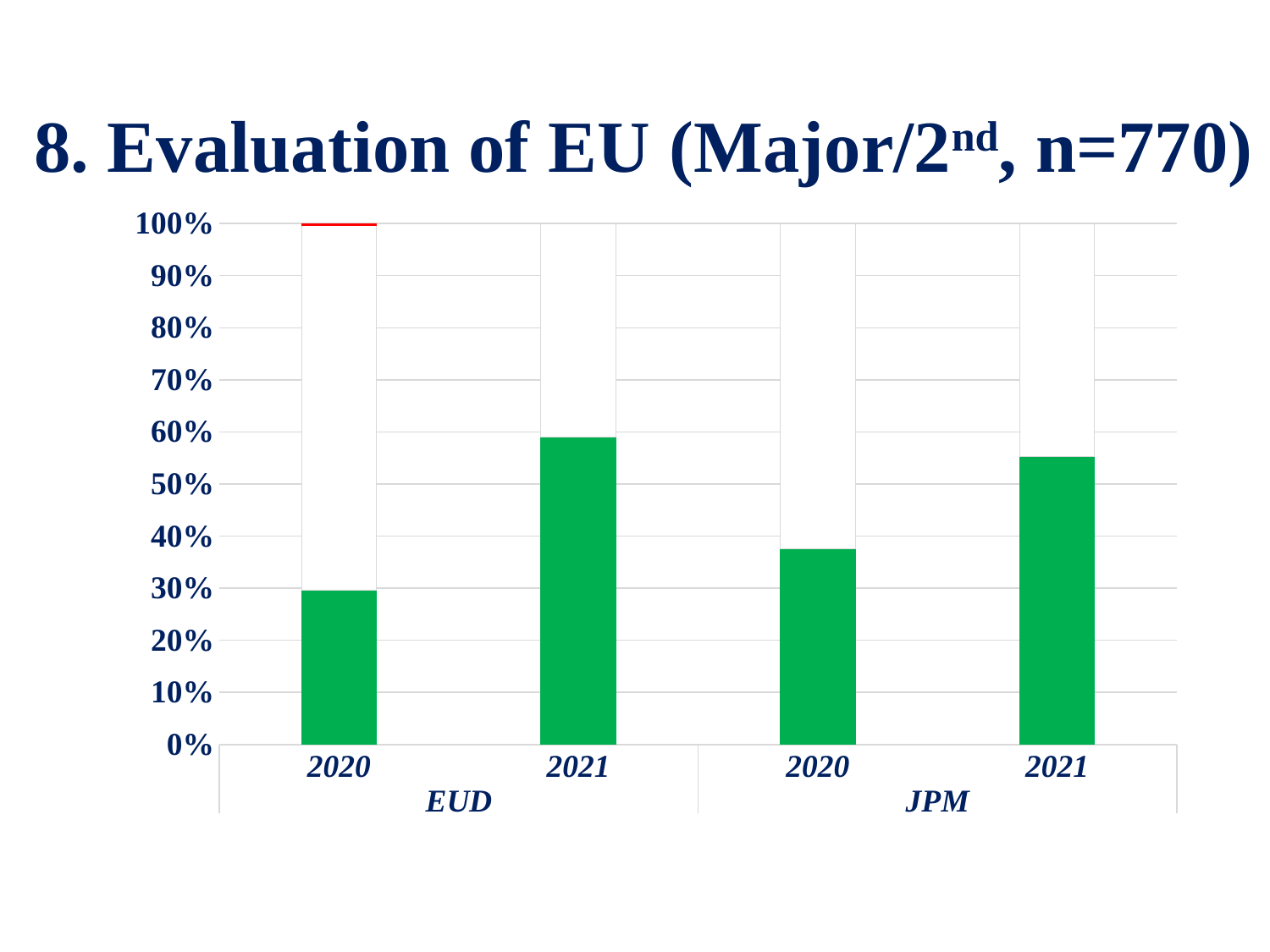
Which bar has the smallest green segment? EUD 2020 Which bar has the largest green segment? EUD 2021 Does the green segment for EUD rise or fall from 2020 to 2021? rise Is the green value for JPM 2020 greater or less than 40%? less What kind of chart is shown on the slide? bar chart Is the green value for EUD 2021 greater or less than 50%? greater Which has the larger green segment, JPM 2020 or JPM 2021? JPM 2021 Is the green value for JPM 2021 greater or less than 50%? greater What is the title of the chart on the slide? 8. Evaluation of EU (Major/2nd, n=770) Which two groups are labelled on the x axis of the chart? EUD and JPM How many bars are plotted in the chart? 4